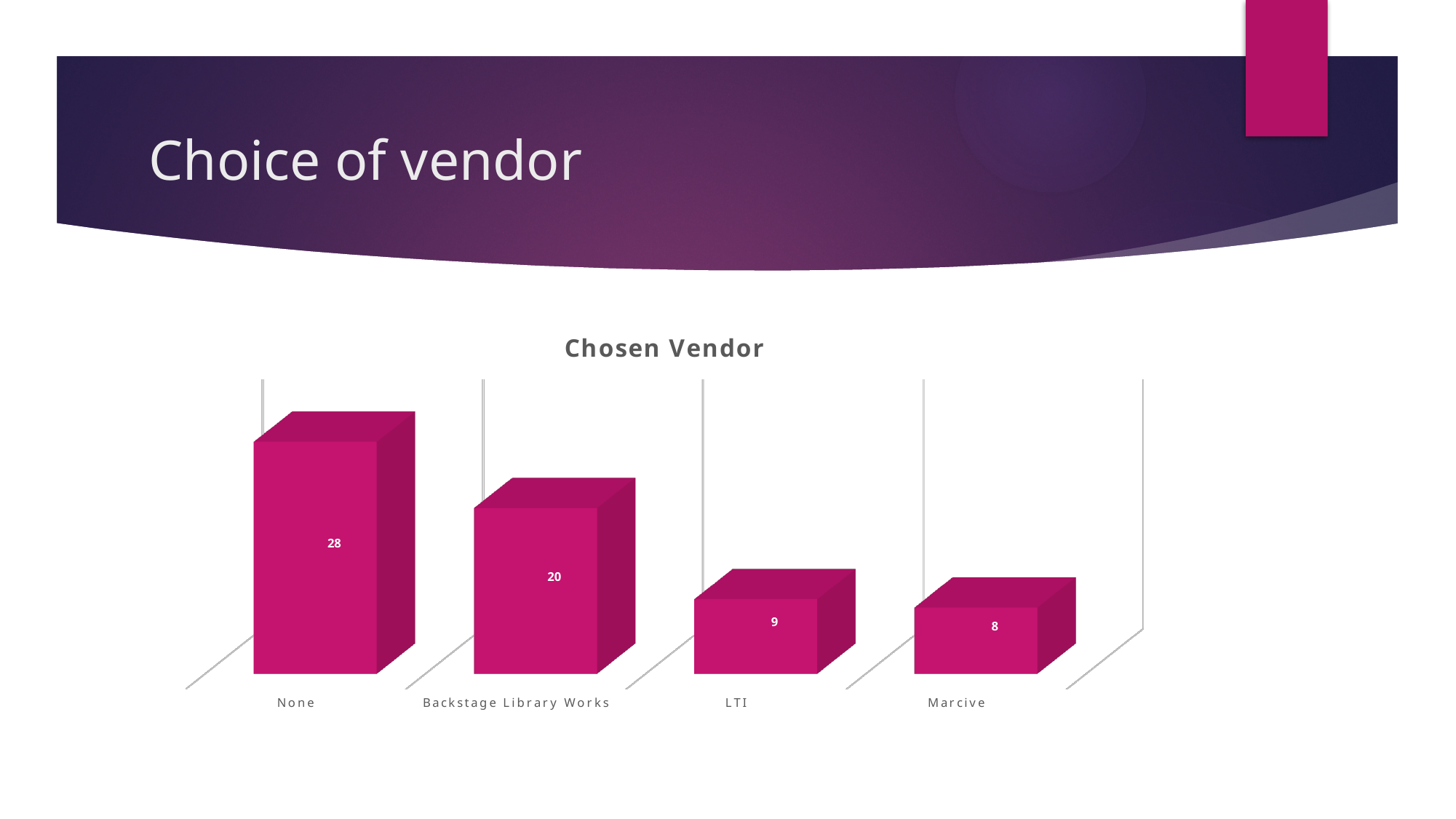
Which category has the highest value? None What is the value for Backstage Library Works? 20 What is the value for LTI? 9 What is the value for None? 28 What kind of chart is shown? bar chart Which category has the lowest value? Marcive How many categories are shown in the chart? 4 Which is larger, the value for Backstage Library Works or the value for LTI? Backstage Library Works What is the title of the chart? Chosen Vendor What is the value for Marcive? 8 What is the difference between the values for None and Backstage Library Works? 8 What is the difference between the values for LTI and Marcive? 1